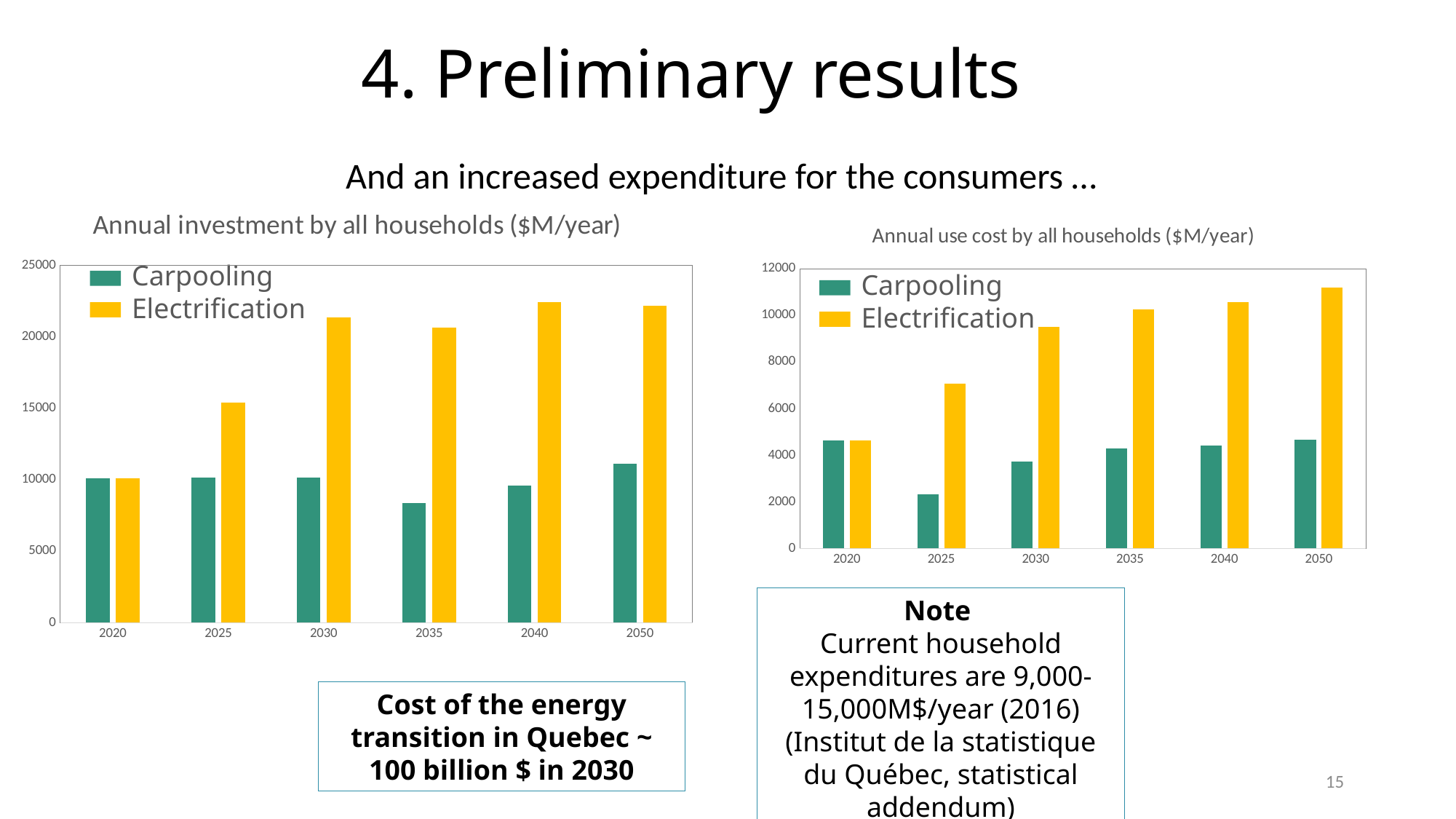
In the 'Annual use cost by all households ($M/year)' chart, is the Electrification value for 2025 greater or less than 6000? greater In the 'Annual use cost by all households ($M/year)' chart, which is larger in 2040: Carpooling or Electrification? Electrification In the 'Annual use cost by all households ($M/year)' chart, which year has the lowest Carpooling value? 2025 How many series does the legend list in the 'Annual use cost by all households ($M/year)' chart? 2 In the 'Annual investment by all households ($M/year)' chart, is the Carpooling value for 2035 greater or less than 10000? less In the 'Annual use cost by all households ($M/year)' chart, do the Electrification values rise or fall from 2020 to 2050? rise In the 'Annual investment by all households ($M/year)' chart, which year has the lowest Carpooling value? 2035 How many years are shown on the x axis of the 'Annual investment by all households ($M/year)' chart? 6 In the 'Annual investment by all households ($M/year)' chart, which year has the highest Carpooling value? 2050 In the 'Annual investment by all households ($M/year)' chart, is the Electrification value for 2030 greater or less than 20000? greater What kind of chart is the 'Annual investment by all households ($M/year)' chart? bar chart In the 'Annual use cost by all households ($M/year)' chart, which year has the highest Electrification value? 2050